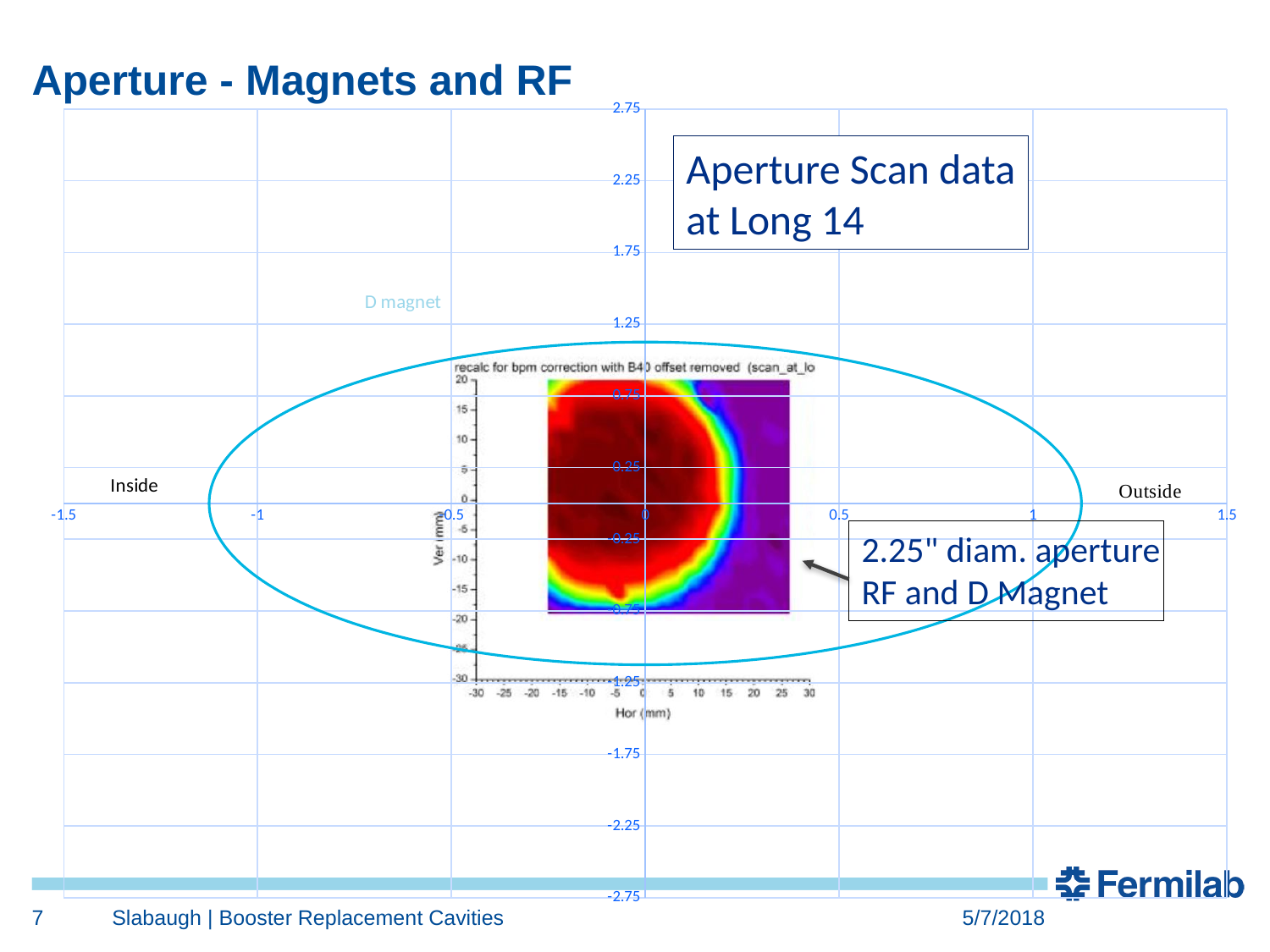
What is the highest tick value shown on the vertical axis of the main chart? 2.75 At which location was the aperture scan data shown on the chart taken? Long 14 What is the maximum tick value on the horizontal axis of the embedded aperture scan plot? 30 According to the annotation on the chart, what is the diameter of the aperture for the RF and D Magnet? 2.25" What series name is printed in light blue text on the main chart? D magnet What is the lowest tick value shown on the horizontal axis of the main chart? -1.5 What is the horizontal axis label of the embedded aperture scan plot? Hor (mm) What is the vertical axis label of the embedded aperture scan plot? Ver (mm) What is the title of the slide containing the chart? Aperture - Magnets and RF Which side of the main chart is labeled "Inside", left or right? left